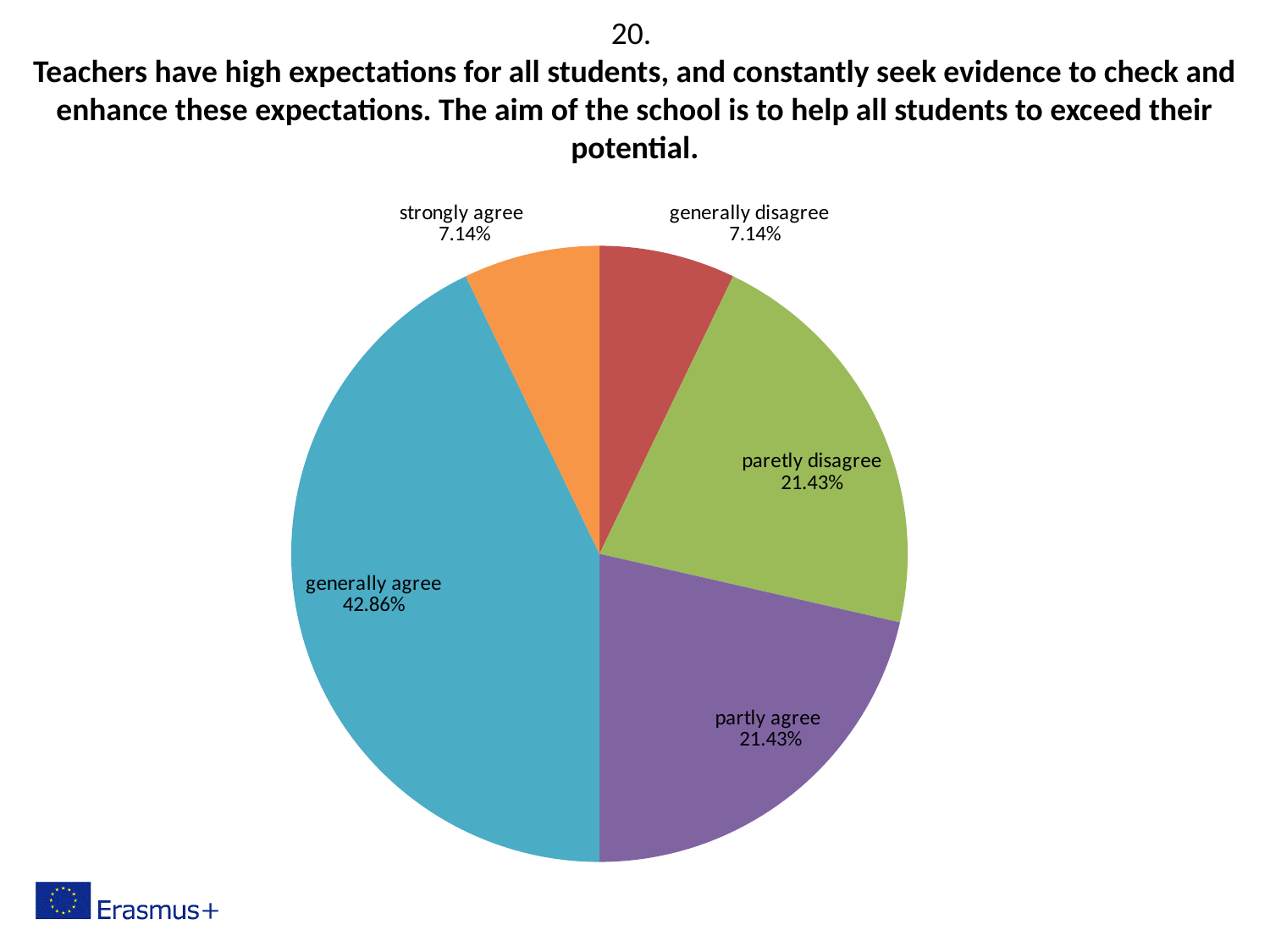
What share of the pie is labelled "partly agree"? 21.43% What colour is the "generally agree" slice? blue What is the combined share of "generally agree" and "strongly agree"? 50% What share of the pie is labelled "generally agree"? 42.86% How many slices does the pie chart have? 5 What is the difference between the "generally agree" share and the "partly agree" share? 21.43% What share of the pie is labelled "generally disagree"? 7.14% What kind of chart is shown on the slide? pie chart What is the difference between the "paretly disagree" share and the "generally disagree" share? 14.29% Which category has the largest slice of the pie? generally agree What share of the pie is labelled "strongly agree"? 7.14% Which is larger, the "paretly disagree" slice or the "strongly agree" slice? paretly disagree